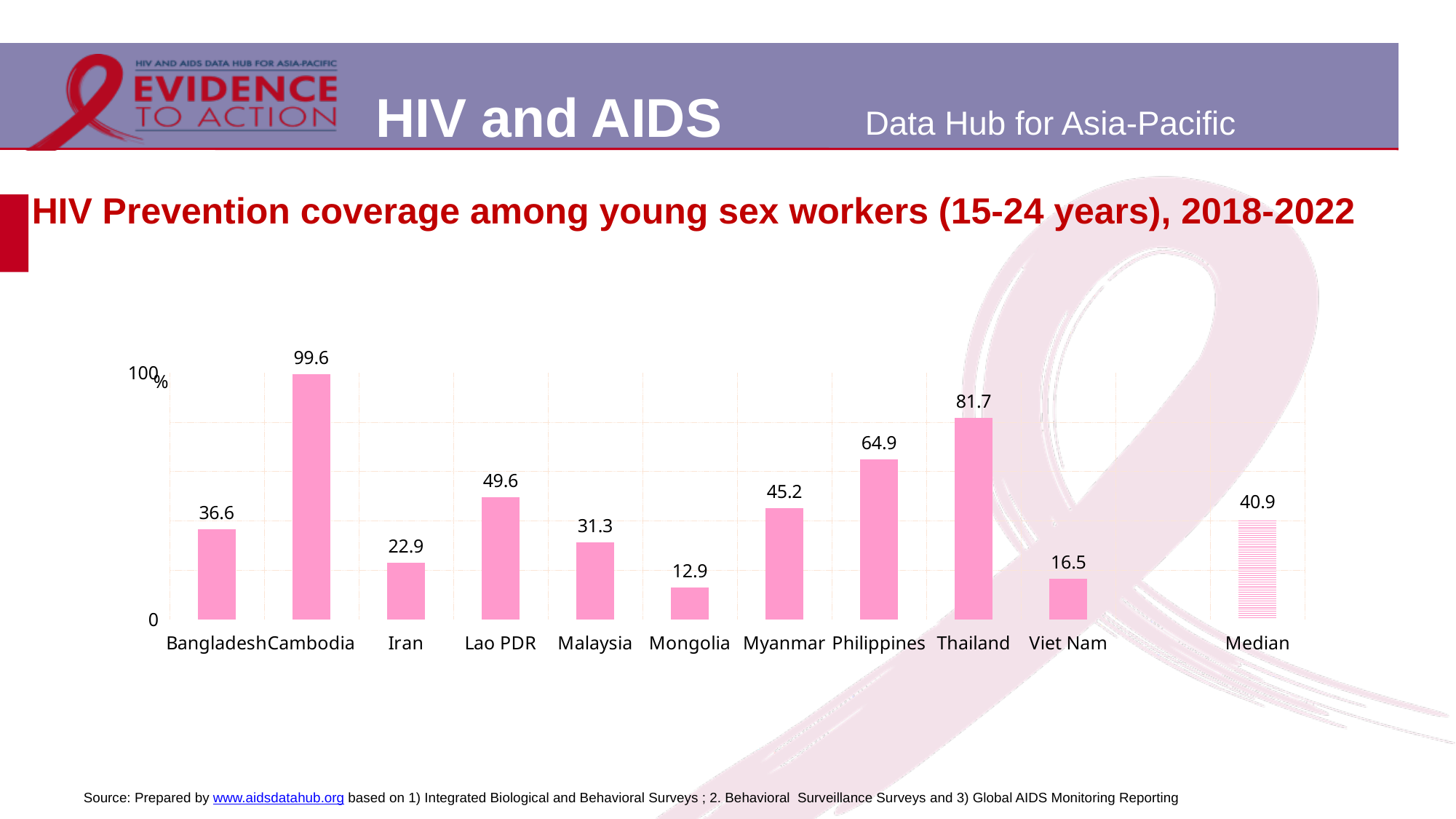
What kind of chart is shown on the slide? Bar chart Which has a higher value, Philippines or Lao PDR? Philippines What is the title of the chart? HIV Prevention coverage among young sex workers (15-24 years), 2018-2022 What is the Median value shown on the chart? 40.9 What is the value shown for Bangladesh? 36.6 Which country has the lowest HIV prevention coverage? Mongolia Is the value for Myanmar greater or less than the Median value? greater What is the difference between the values for Thailand and Viet Nam? 65.2 What is the HIV prevention coverage value for Cambodia? 99.6 Which country has the highest HIV prevention coverage? Cambodia How many countries (excluding the Median bar) are shown on the chart? 10 What is the value shown for Mongolia? 12.9